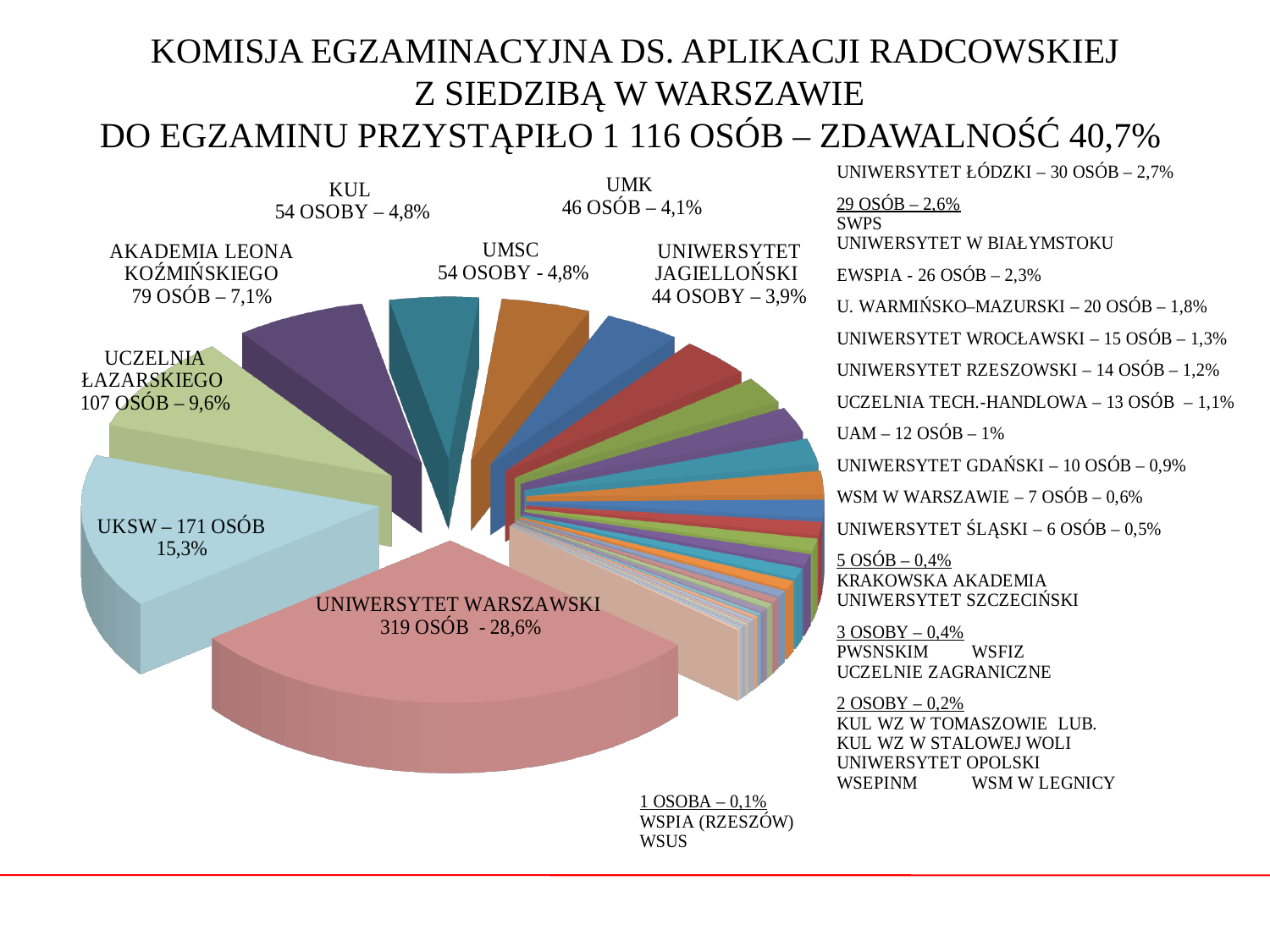
What is the total number of people who took the exam, according to the title? 1 116 OSÓB How many people from UCZELNIA ŁAZARSKIEGO took the exam? 107 OSÓB Which has more people, UMK or UNIWERSYTET JAGIELLOŃSKI? UMK How many people from UNIWERSYTET WARSZAWSKI took the exam? 319 OSÓB What percentage is shown for UAM? 1% What kind of chart is shown on the slide? pie chart What pass rate (zdawalność) is given in the title? 40,7% Which institution has the largest slice of the pie? UNIWERSYTET WARSZAWSKI How many people are listed for UNIWERSYTET ŁÓDZKI? 30 OSÓB What is the difference in number of people between UNIWERSYTET WARSZAWSKI and UKSW? 148 What percentage is shown for AKADEMIA LEONA KOŹMIŃSKIEGO? 7,1% What share of the pie does UKSW represent? 15,3%